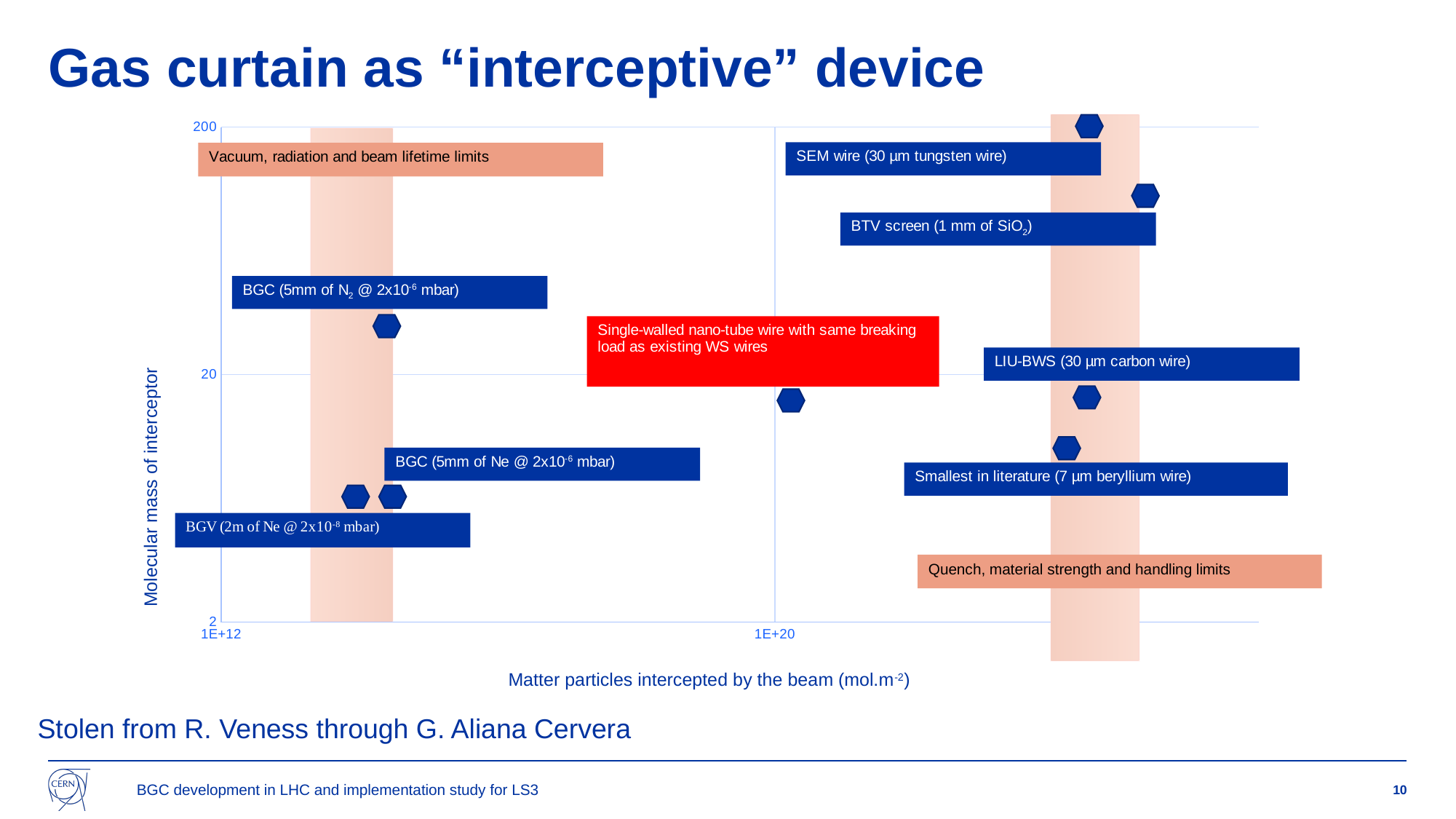
Is the matter particles intercepted value for BGC (5mm of N2 @ 2x10-6 mbar) greater or less than 1E+20? less Is the molecular mass for BGC (5mm of N2 @ 2x10-6 mbar) greater or less than 20? greater Which interceptor has the highest molecular mass on the chart? SEM wire (30 µm tungsten wire) How many data points (hexagon markers) are plotted on the chart? 8 What is the label of the x axis? Matter particles intercepted by the beam (mol.m-2) Is the molecular mass for LIU-BWS (30 µm carbon wire) greater or less than 20? less What is the label of the y axis? Molecular mass of interceptor Which has the higher molecular mass, BGC (5mm of N2 @ 2x10-6 mbar) or BGC (5mm of Ne @ 2x10-6 mbar)? BGC (5mm of N2 @ 2x10-6 mbar) What kind of chart is shown on the slide? scatter chart